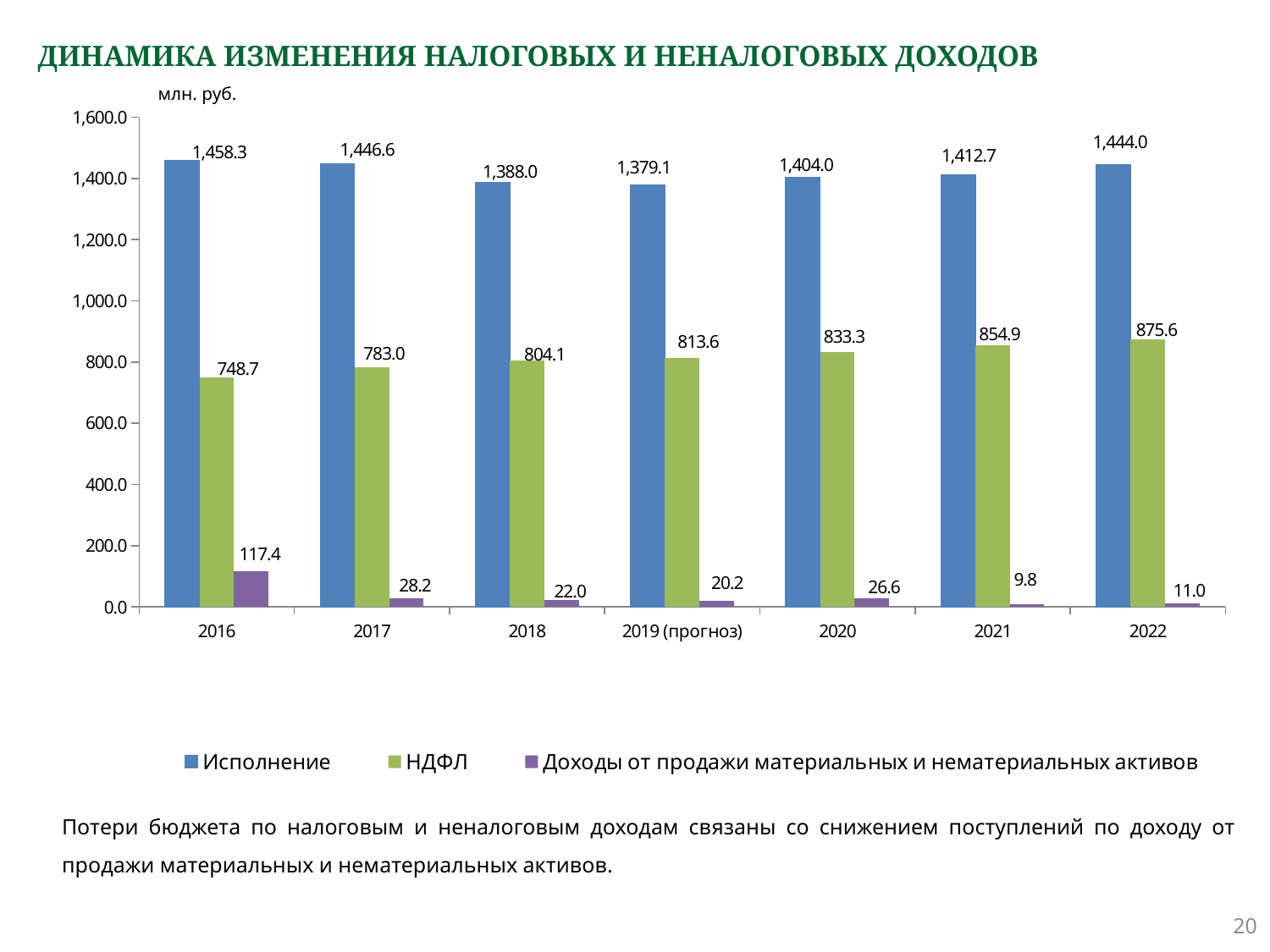
What is the difference between the НДФЛ values for 2022 and 2016? 126.9 Which year has the highest value for НДФЛ? 2022 How many series does the legend list? 3 Which is larger: Исполнение for 2017 or Исполнение for 2022? 2017 Which year has the lowest value for Исполнение? 2019 (прогноз) What is the value of Исполнение for 2016? 1,458.3 What unit is shown above the vertical axis? млн. руб. What is the value of Доходы от продажи материальных и нематериальных активов for 2021? 9.8 Do the НДФЛ values rise or fall from 2016 to 2022? rise How many years are shown on the x axis? 7 What kind of chart is shown on the slide? bar chart What is the value of НДФЛ for 2020? 833.3